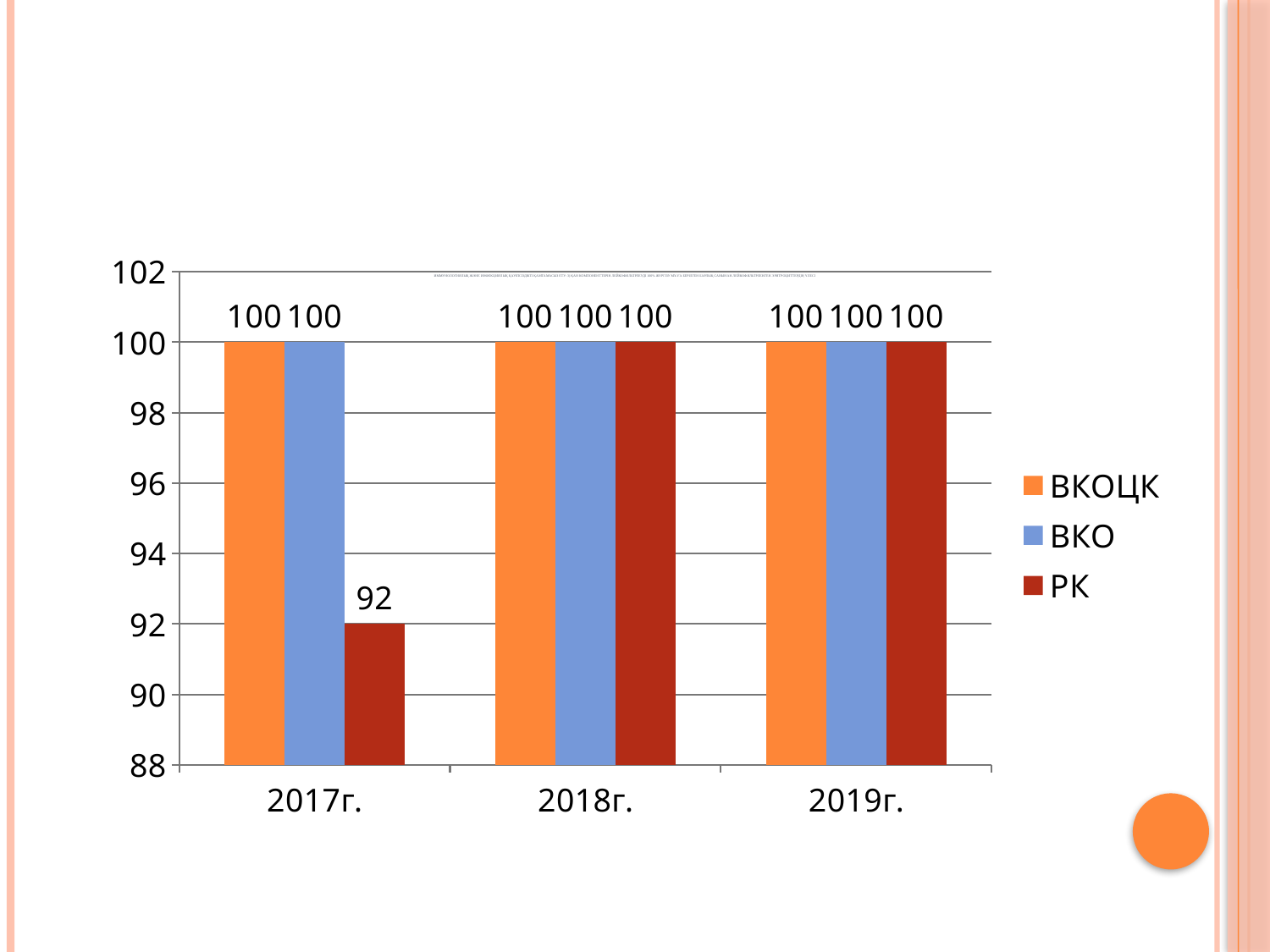
What is the value for РК in 2017г.? 92 Which series has the lowest value in 2017г.? РК What is the value for ВКО in 2019г.? 100 What colour represents the РК series in the legend? dark red Is the value for РК in 2017г. greater or less than 94? less Which is larger in 2017г., the value for ВКОЦК or the value for РК? ВКОЦК What is the value for ВКОЦК in 2018г.? 100 Does the value for РК rise or fall from 2017г. to 2018г.? rise What kind of chart is shown on the slide? bar chart How many categories are shown on the x axis? 3 How many series does the legend list? 3 What is the difference between the ВКО value and the РК value in 2017г.? 8